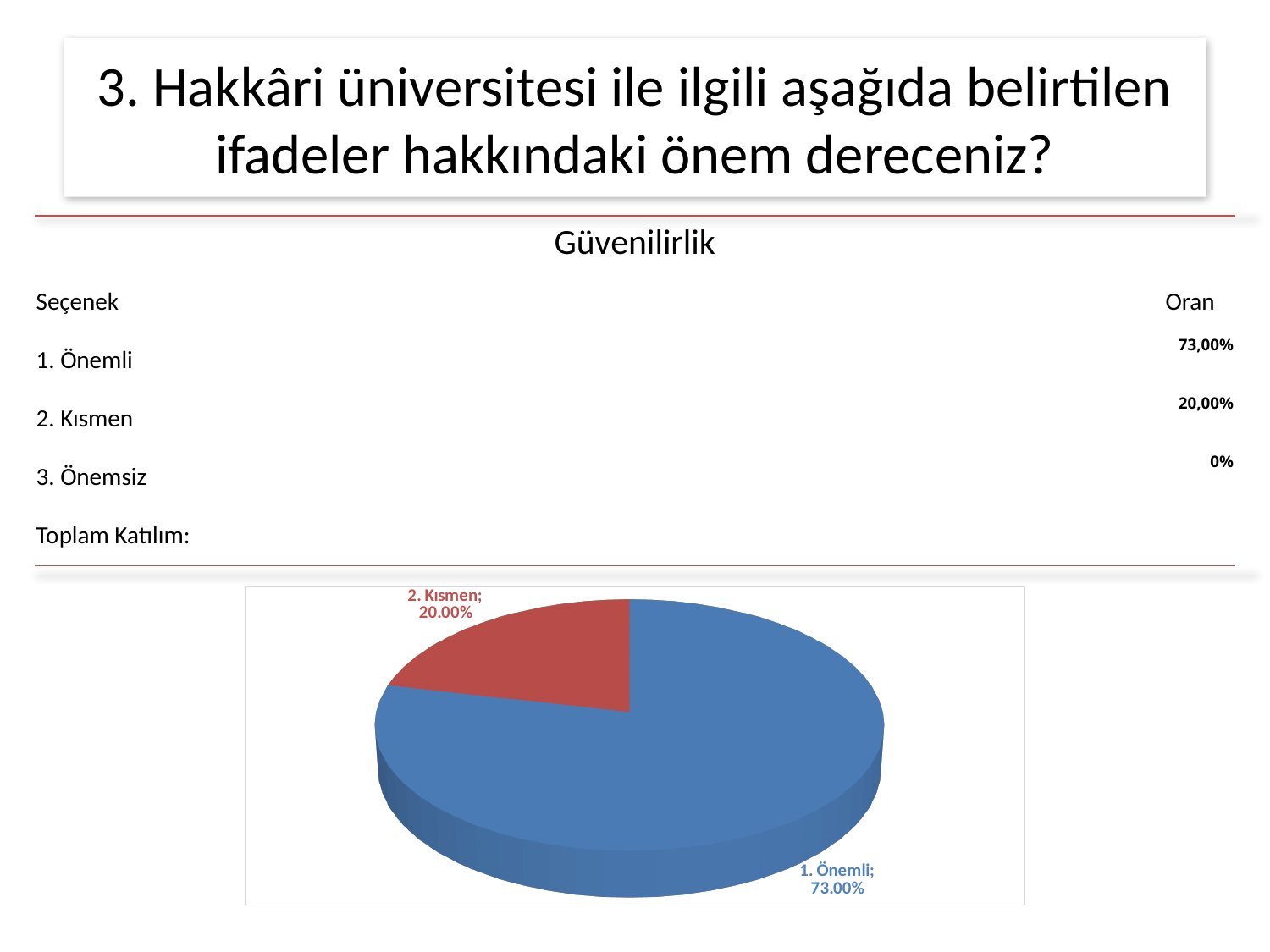
Which slice is larger in the pie chart, "1. Önemli" or "2. Kısmen"? 1. Önemli Which category has the largest slice in the pie chart? 1. Önemli How many labelled slices does the pie chart have? 2 What percentage does the pie chart show for "1. Önemli"? 73.00% What colour is the "2. Kısmen" slice in the pie chart? Red What is the difference in percentage points between the "1. Önemli" and "2. Kısmen" slices in the pie chart? 53.00% What colour is the "1. Önemli" slice in the pie chart? Blue What percentage does the pie chart show for "2. Kısmen"? 20.00% What kind of chart is shown on the slide? Pie chart Which of the labelled slices in the pie chart is the smallest? 2. Kısmen What share of the pie does the "2. Kısmen" slice represent? 20.00%